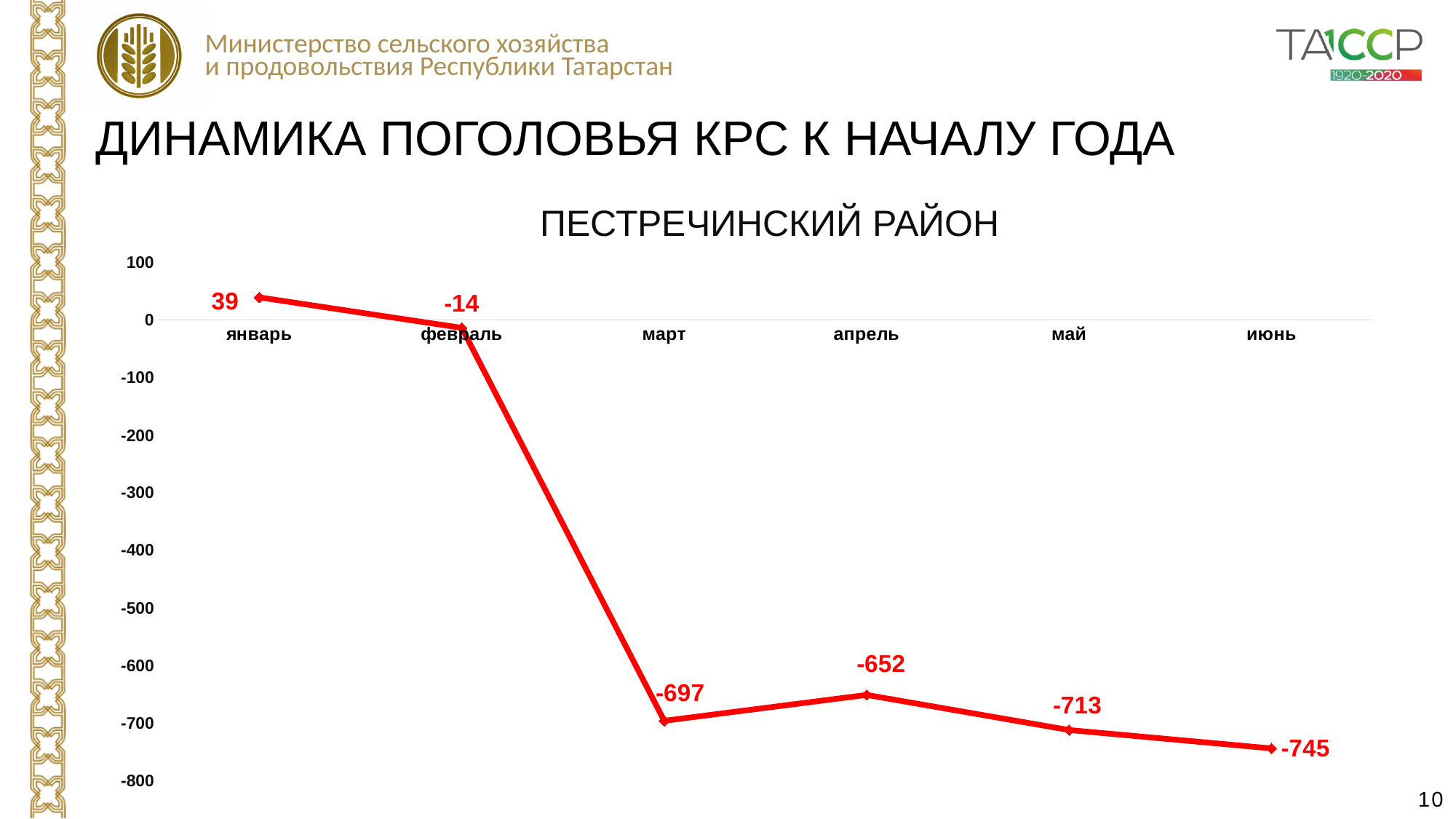
How many months are plotted on the chart? 6 Which month has the highest value? январь What is the value for март? -697 What is the difference between the values for февраль and март? 683 What is the value for апрель? -652 What kind of chart is shown? line chart Which month has the lowest value? июнь Is the value for май greater or less than -600? less What is the title of the chart? ПЕСТРЕЧИНСКИЙ РАЙОН What is the value for июнь? -745 What is the value for январь? 39 Which is larger, the value for апрель or the value for май? апрель